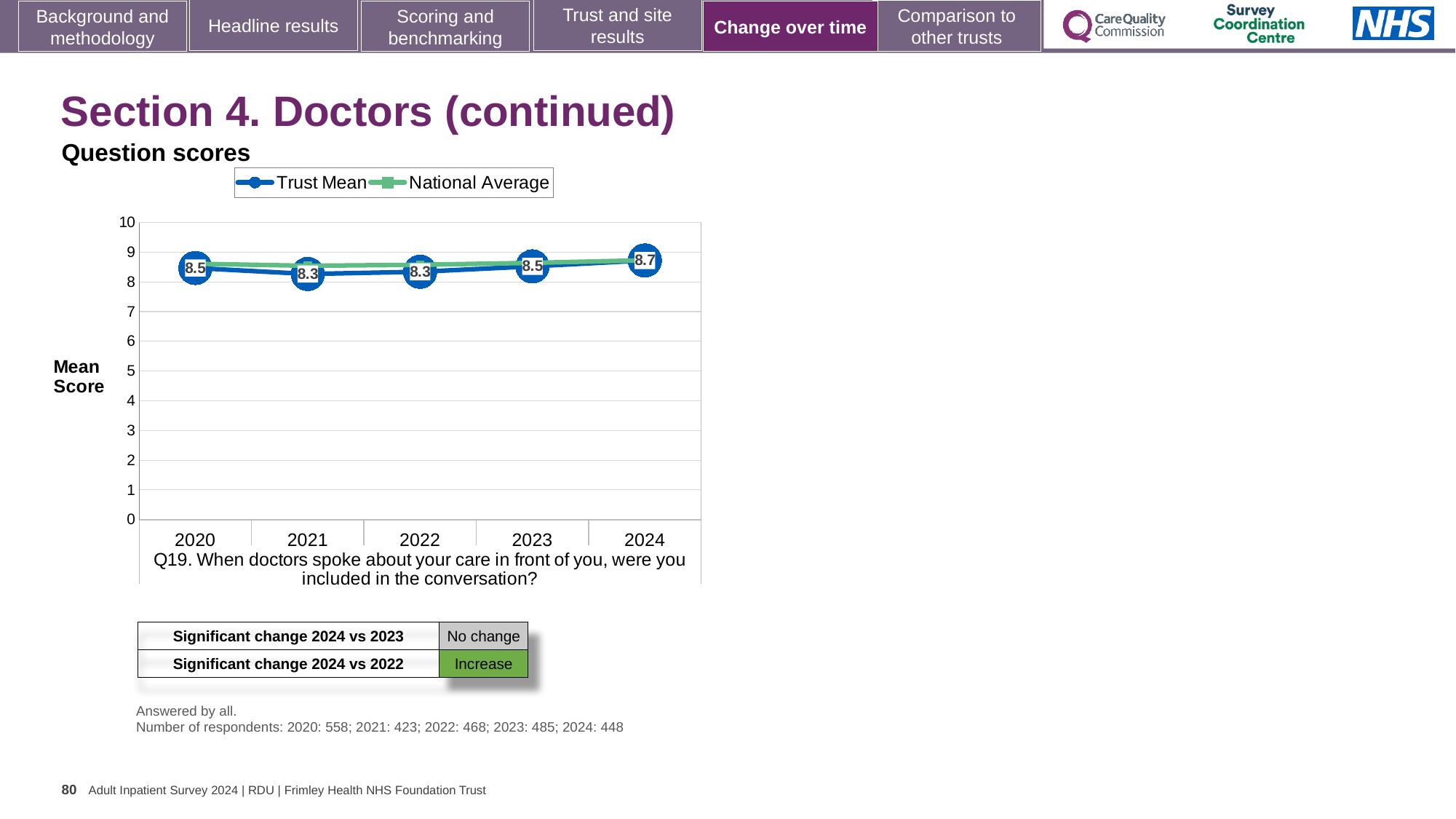
Is the National Average value for 2020 greater or less than 8? greater What kind of chart is shown on the slide? Line chart Does the Trust Mean score rise or fall from 2022 to 2024? Rise What is the Trust Mean score for 2024? 8.7 Which is larger, the Trust Mean score for 2024 or for 2020? 2024 What is the difference between the Trust Mean score in 2024 and in 2021? 0.4 What is the label on the y axis of the chart? Mean Score How many series does the legend list? 2 How many years are plotted on the x axis? 5 What is the Trust Mean score for 2020? 8.5 In which year is the Trust Mean score highest? 2024 What is the Trust Mean score for 2021? 8.3